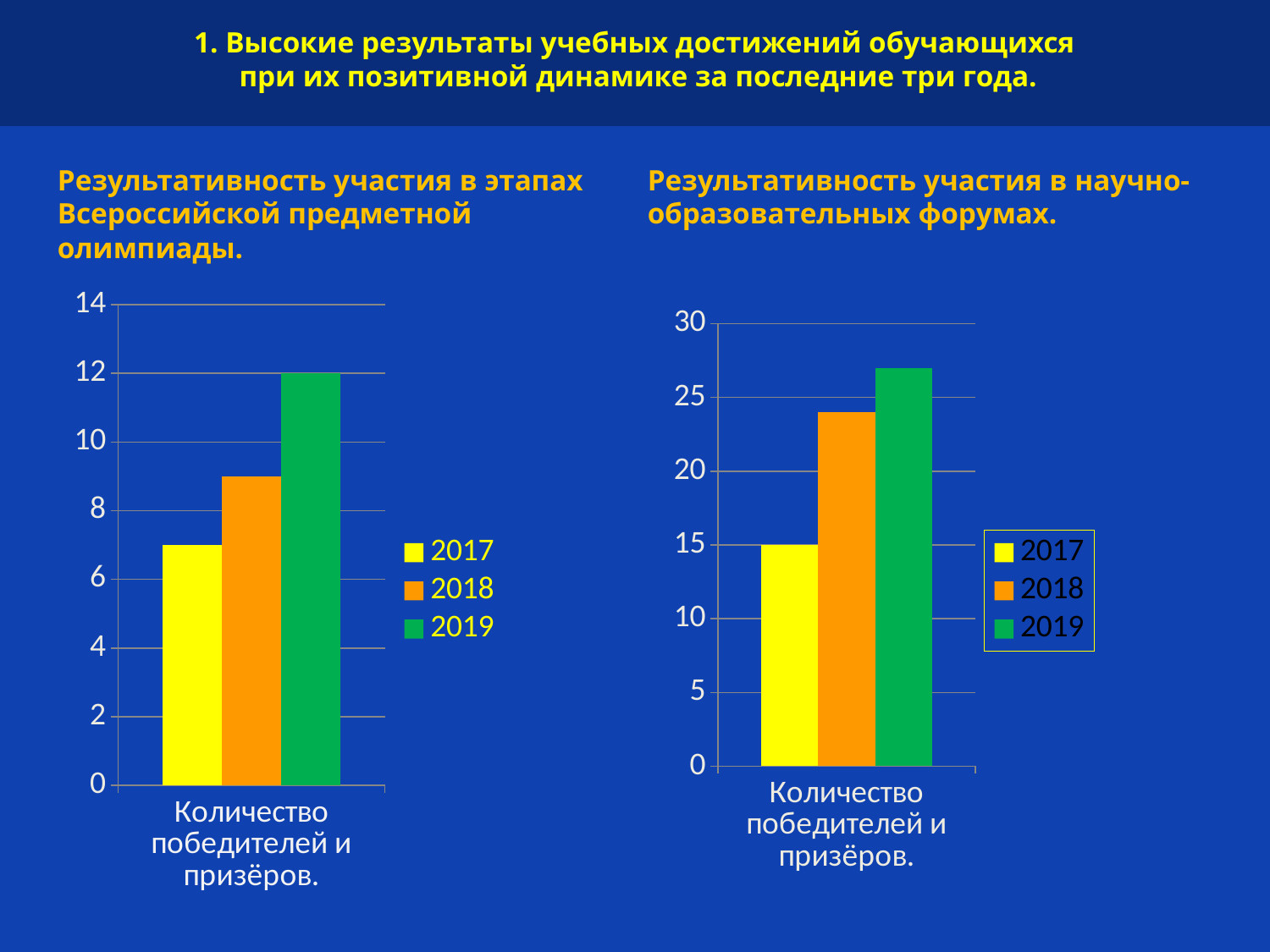
On the right chart (научно-образовательных форумах), what is the value for 2017? 15 On the left chart (Всероссийской предметной олимпиады), what is the value for 2019? 12 On the left chart, is the value for 2017 greater or less than 8? less On the right chart, is the value for 2018 greater or less than 20? greater On the right chart, is the value for 2019 greater or less than 25? greater On the right chart, which year has the lowest value? 2017 How many series does the legend of the right chart list? 3 On the right chart, which year has the highest value? 2019 On the left chart, which year has the highest value? 2019 On the left chart, which year has the lowest value? 2017 On the left chart, which is larger, the value for 2018 or the value for 2017? 2018 What kind of chart is the left chart? bar chart